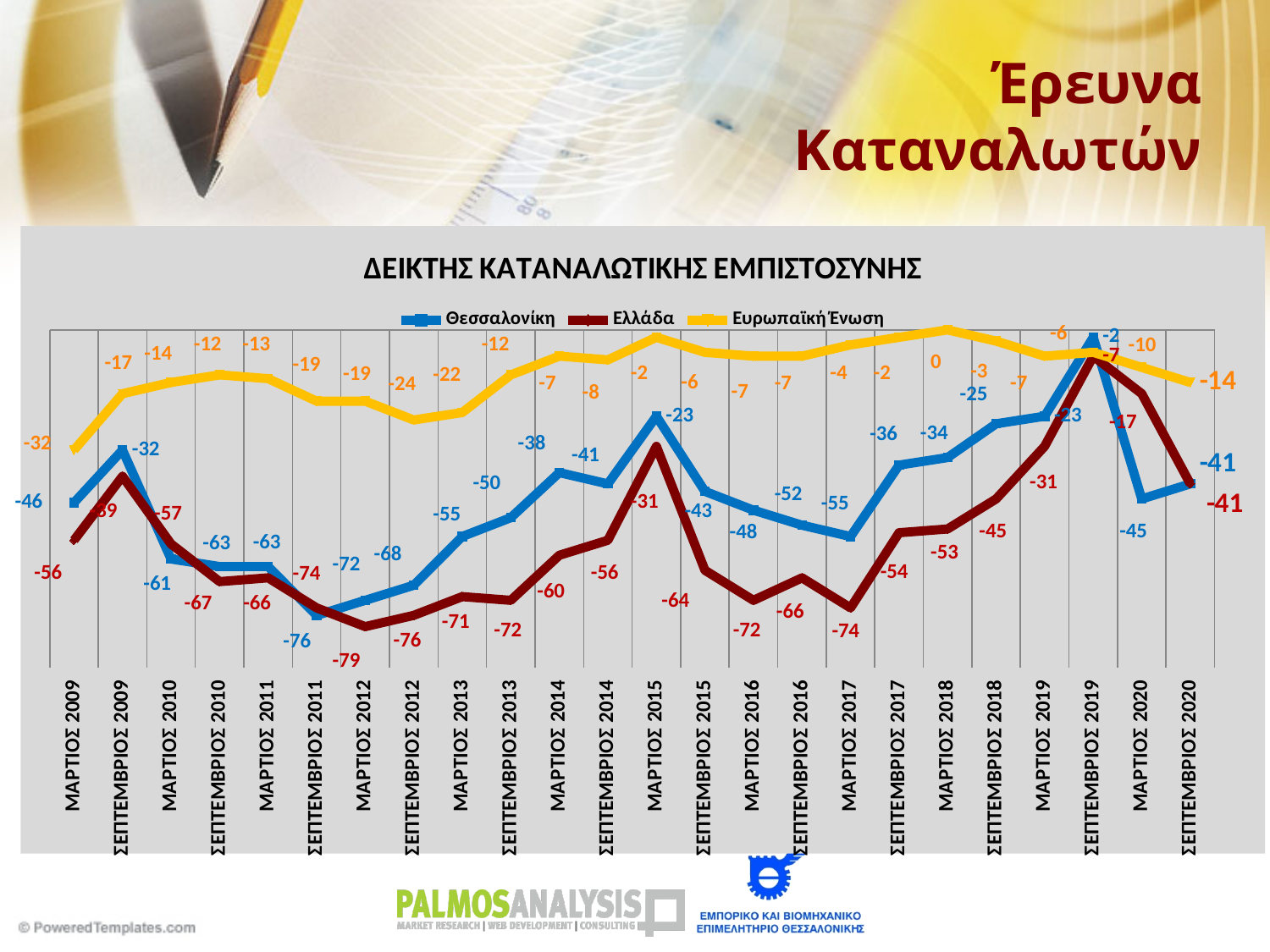
What kind of chart is shown on the slide? line chart In ΜΑΡΤΙΟΣ 2009, which series has the higher value, Θεσσαλονίκη or Ελλάδα? Θεσσαλονίκη What is the title of the chart? ΔΕΙΚΤΗΣ ΚΑΤΑΝΑΛΩΤΙΚΗΣ ΕΜΠΙΣΤΟΣΥΝΗΣ What is the value for Θεσσαλονίκη in ΜΑΡΤΙΟΣ 2015? -23 How many series does the legend of the chart list? 3 How many time points are plotted along the x axis of the chart? 24 What is the value for Ευρωπαϊκή Ένωση in ΜΑΡΤΙΟΣ 2018? 0 What is the value for Ελλάδα in ΣΕΠΤΕΜΒΡΙΟΣ 2020? -41 In which period does the Ελλάδα series reach its lowest value? ΜΑΡΤΙΟΣ 2012 What is the difference between the Ελλάδα value and the Θεσσαλονίκη value in ΜΑΡΤΙΟΣ 2020? 28 In which period does the Θεσσαλονίκη series reach its highest value? ΣΕΠΤΕΜΒΡΙΟΣ 2019 What is the value for Ελλάδα in ΜΑΡΤΙΟΣ 2012? -79